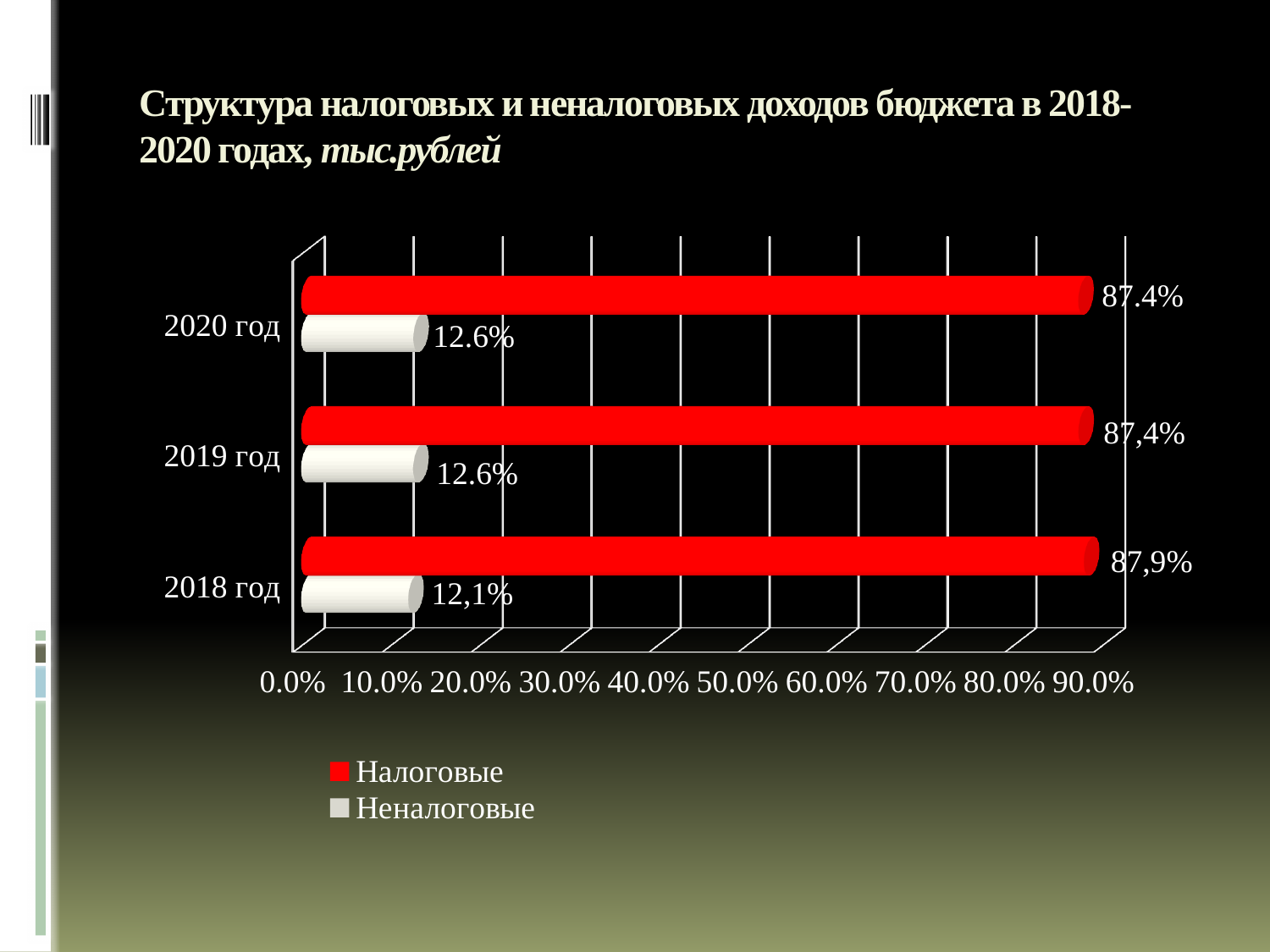
What is the value for Налоговые in 2018 год? 87,9% How many series does the legend list? 2 What kind of chart is shown on the slide? bar chart What is the value for Неналоговые in 2018 год? 12,1% Which year has the lowest value for Неналоговые? 2018 год What is the value for Неналоговые in 2019 год? 12.6% What is the value for Налоговые in 2020 год? 87.4% Which is larger in 2020 год, Налоговые or Неналоговые? Налоговые How many years are shown on the chart? 3 Is the value for Налоговые in 2019 год greater or less than 80.0%? greater What is the difference between the Налоговые and Неналоговые values in 2018 год? 75,8% Which year has the highest value for Налоговые? 2018 год